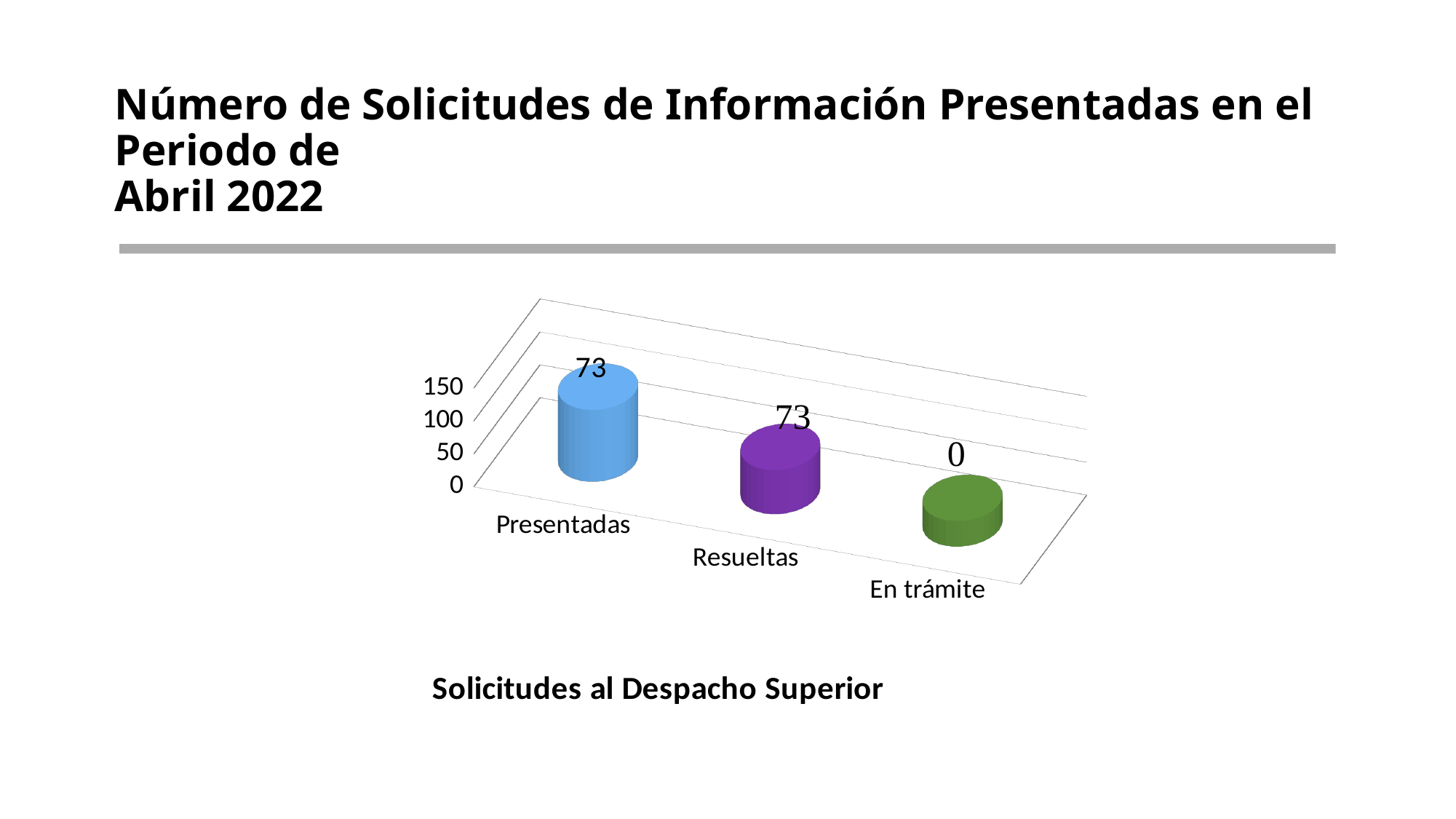
How many categories are shown in the chart? 3 What is the title shown below the chart? Solicitudes al Despacho Superior What kind of chart is shown on the slide? bar chart What is the value for En trámite? 0 What is the value for Presentadas? 73 What colour is the bar for En trámite? green What is the difference between the values for Presentadas and En trámite? 73 What is the value for Resueltas? 73 Is the value for Resueltas greater or less than 50? greater Which category has the lowest value? En trámite What is the difference between the values for Presentadas and Resueltas? 0